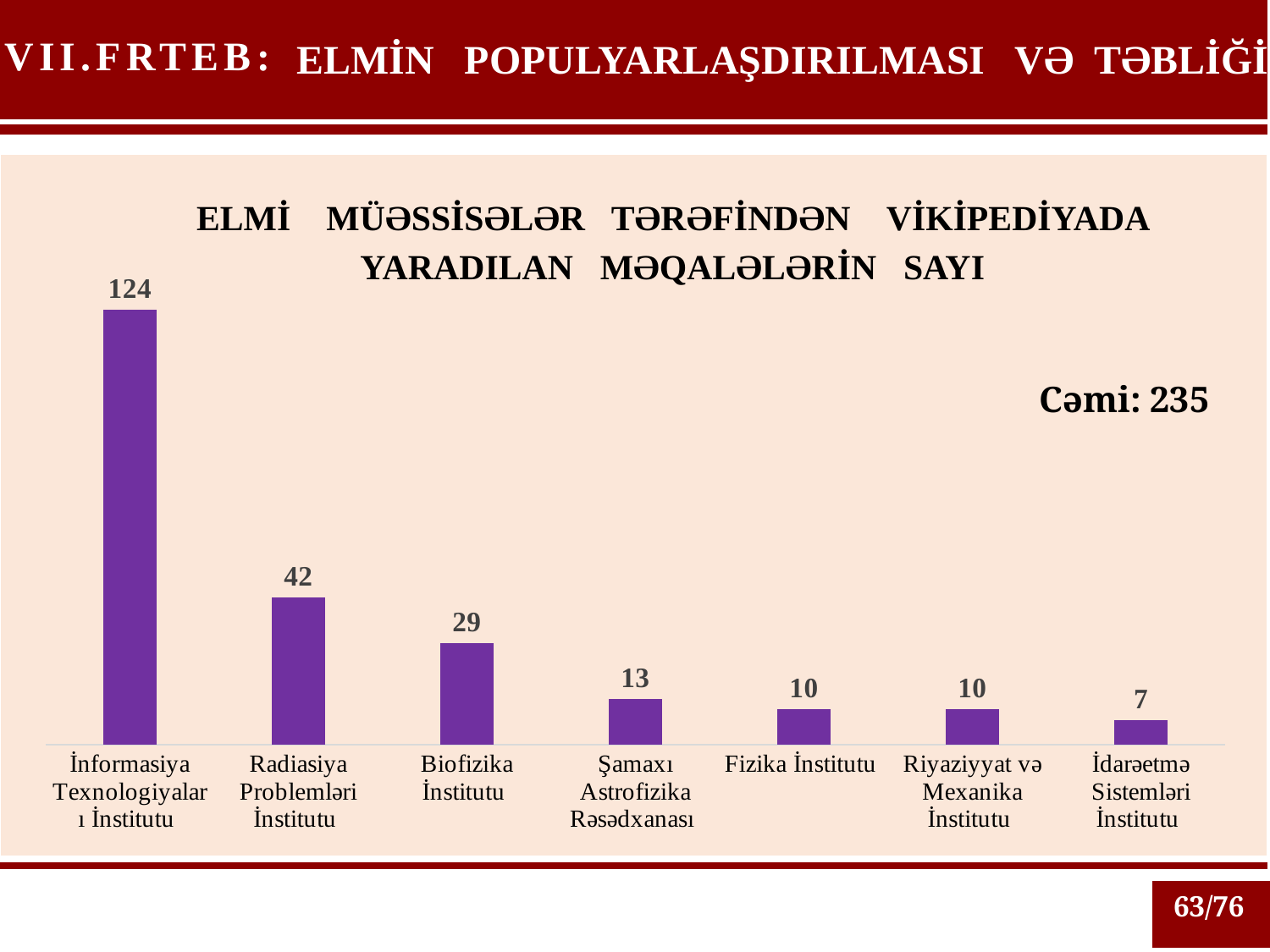
What is the value for Fizika İnstitutu? 10 What kind of chart is shown on the slide? bar chart What total (Cəmi) is shown on the slide? 235 Which is larger, the value for Radiasiya Problemləri İnstitutu or Biofizika İnstitutu? Radiasiya Problemləri İnstitutu Do the values rise or fall from left to right along the x axis? fall What is the value for Biofizika İnstitutu? 29 What is the difference between the values for İnformasiya Texnologiyaları İnstitutu and Radiasiya Problemləri İnstitutu? 82 Which category has the lowest value? İdarəetmə Sistemləri İnstitutu Which category has the highest value? İnformasiya Texnologiyaları İnstitutu What is the value for İdarəetmə Sistemləri İnstitutu? 7 How many categories are shown in the chart? 7 What is the value for Şamaxı Astrofizika Rəsədxanası? 13